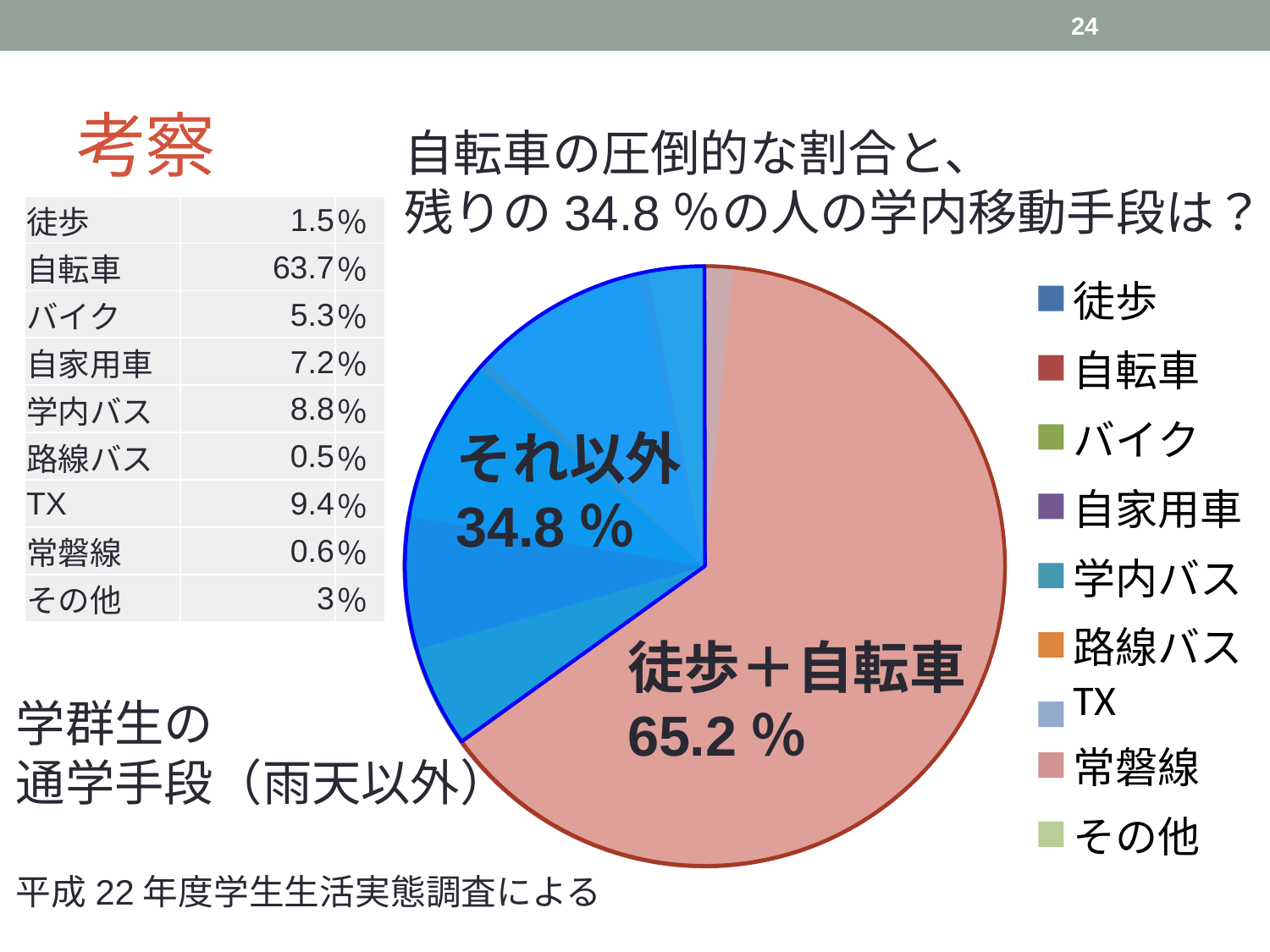
What is the value for 学内バス in the table on the slide? 8.8% What source is cited for the data at the bottom of the slide? 平成22年度学生生活実態調査 What share of the pie is labelled 徒歩＋自転車? 65.2 % What is the value for TX in the table on the slide? 9.4% What is the difference between the values for 自転車 and 徒歩 in the table? 62.2% Which is larger, the value for 自家用車 or the value for バイク? 自家用車 What is the value for 自転車 in the table on the slide? 63.7% What is the title of the pie chart shown on the slide? 学群生の通学手段（雨天以外） What share of the pie is labelled それ以外? 34.8 % Which category has the largest slice of the pie chart? 自転車 What kind of chart is shown on the slide? pie chart How many categories does the legend of the pie chart list? 9